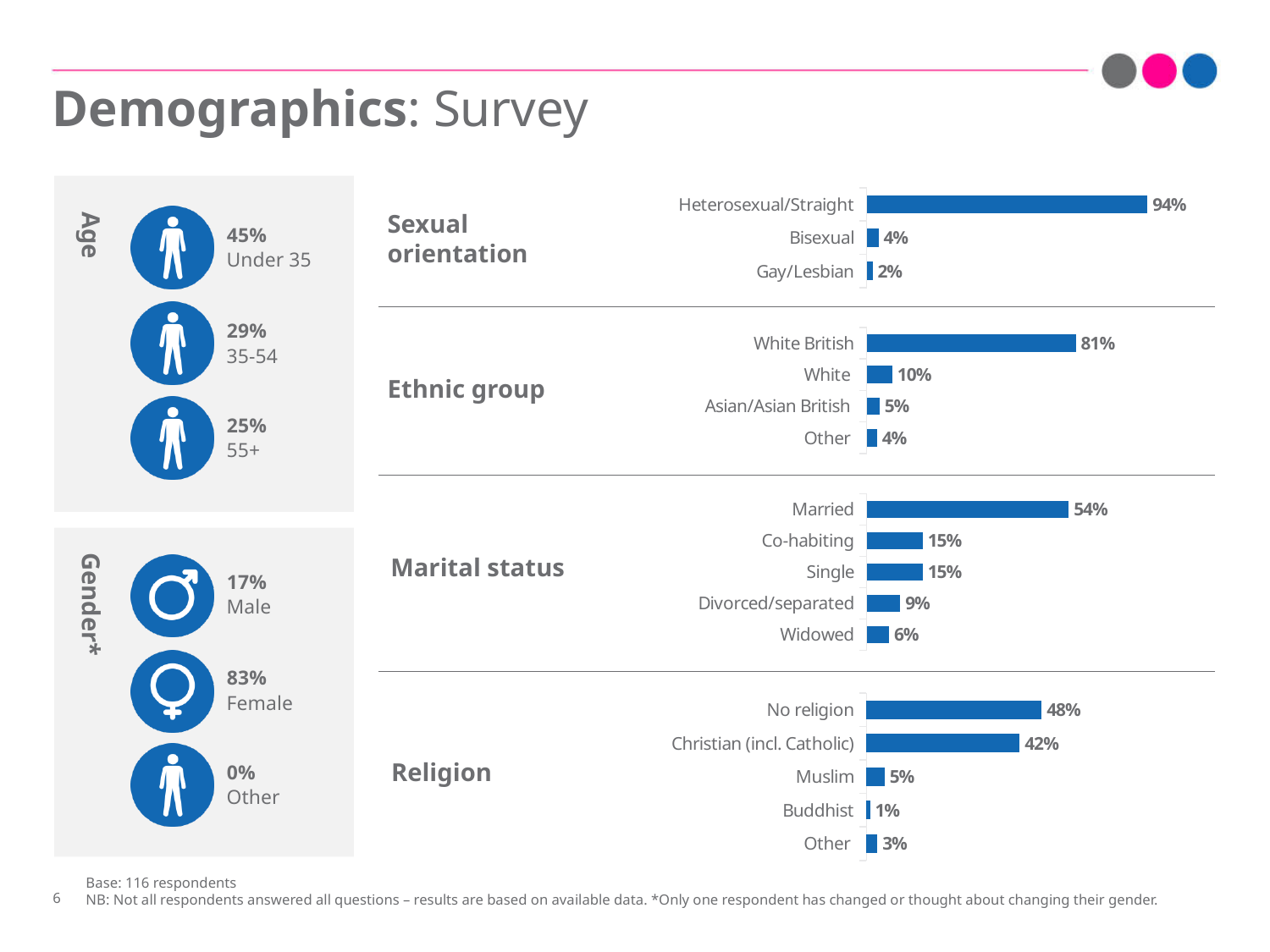
In the Marital status chart, which category has the highest value? Married In the Ethnic group chart, what is the value for White? 10% In the Religion chart, what is the difference between No religion and Christian (incl. Catholic)? 6% What kind of chart is the Ethnic group chart? Bar chart In the Ethnic group chart, which is larger, Asian/Asian British or Other? Asian/Asian British In the Sexual orientation chart, what is the difference between Bisexual and Gay/Lesbian? 2% How many categories does the Marital status chart show? 5 In the Marital status chart, what is the value for Widowed? 6% In the Marital status chart, what is the combined value of Co-habiting and Single? 30% In the Sexual orientation chart, what is the value for Heterosexual/Straight? 94% In the Religion chart, which category has the lowest value? Buddhist How many categories does the Religion chart show? 5